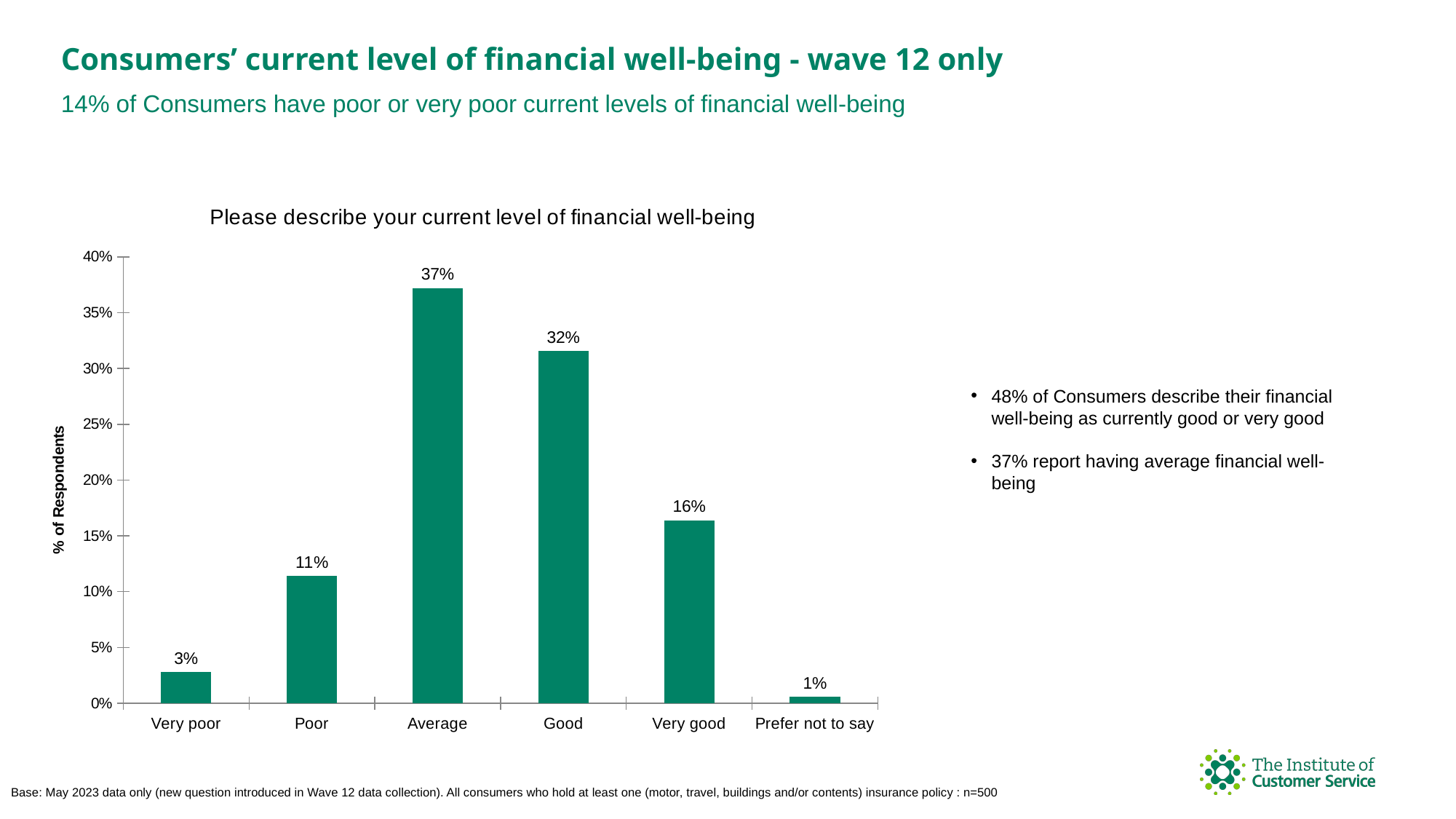
What is the value for Prefer not to say? 1% What is the title of the chart? Please describe your current level of financial well-being Which is larger, the value for Poor or the value for Very good? Very good What is the difference in percentage points between Good and Very good? 16% What kind of chart is shown on the slide? Bar chart Is the value for Good greater or less than 30%? greater How many categories are shown on the x axis? 6 Which category has the highest percentage of respondents? Average What percentage of respondents describe their financial well-being as Average? 37% Which category has the lowest percentage of respondents? Prefer not to say What is the label on the vertical axis of the chart? % of Respondents What percentage of respondents describe their financial well-being as Very poor? 3%